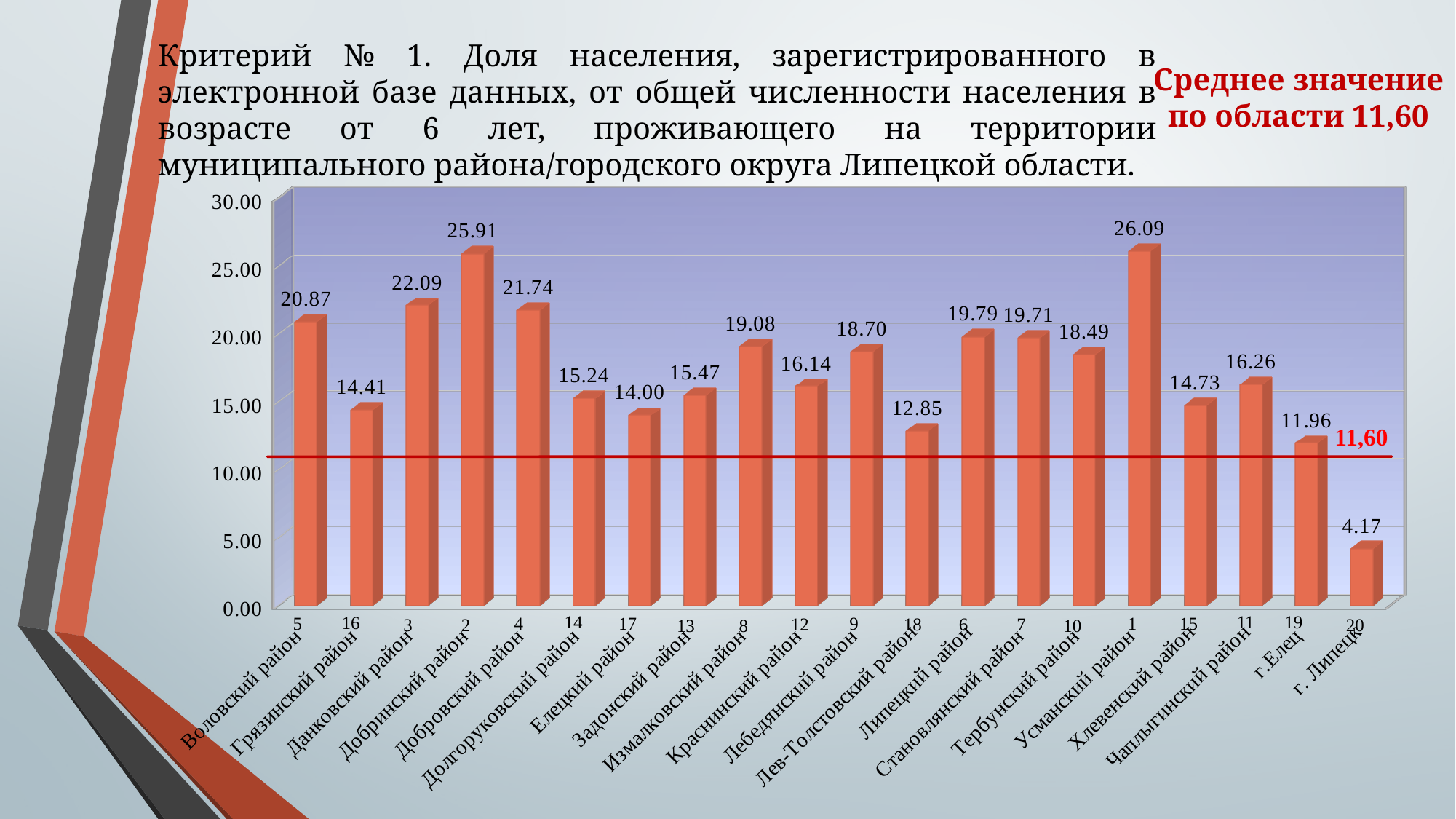
What is the value for г. Липецк? 4.17 What is the difference between the values for Усманский район and Добринский район? 0.18 Which category has the lowest value? г. Липецк What is the value for Лев-Толстовский район? 12.85 Which category has the highest value? Усманский район What is the difference between the values for Липецкий район and Становлянский район? 0.08 Which is larger, the value for Данковский район or the value for Добровский район? Данковский район What kind of chart is shown on the slide? bar chart Is the value for г.Елец greater or less than 15.00? less What value does the red horizontal line on the chart mark? 11,60 What is the value for Добринский район? 25.91 How many categories are shown on the x axis? 20